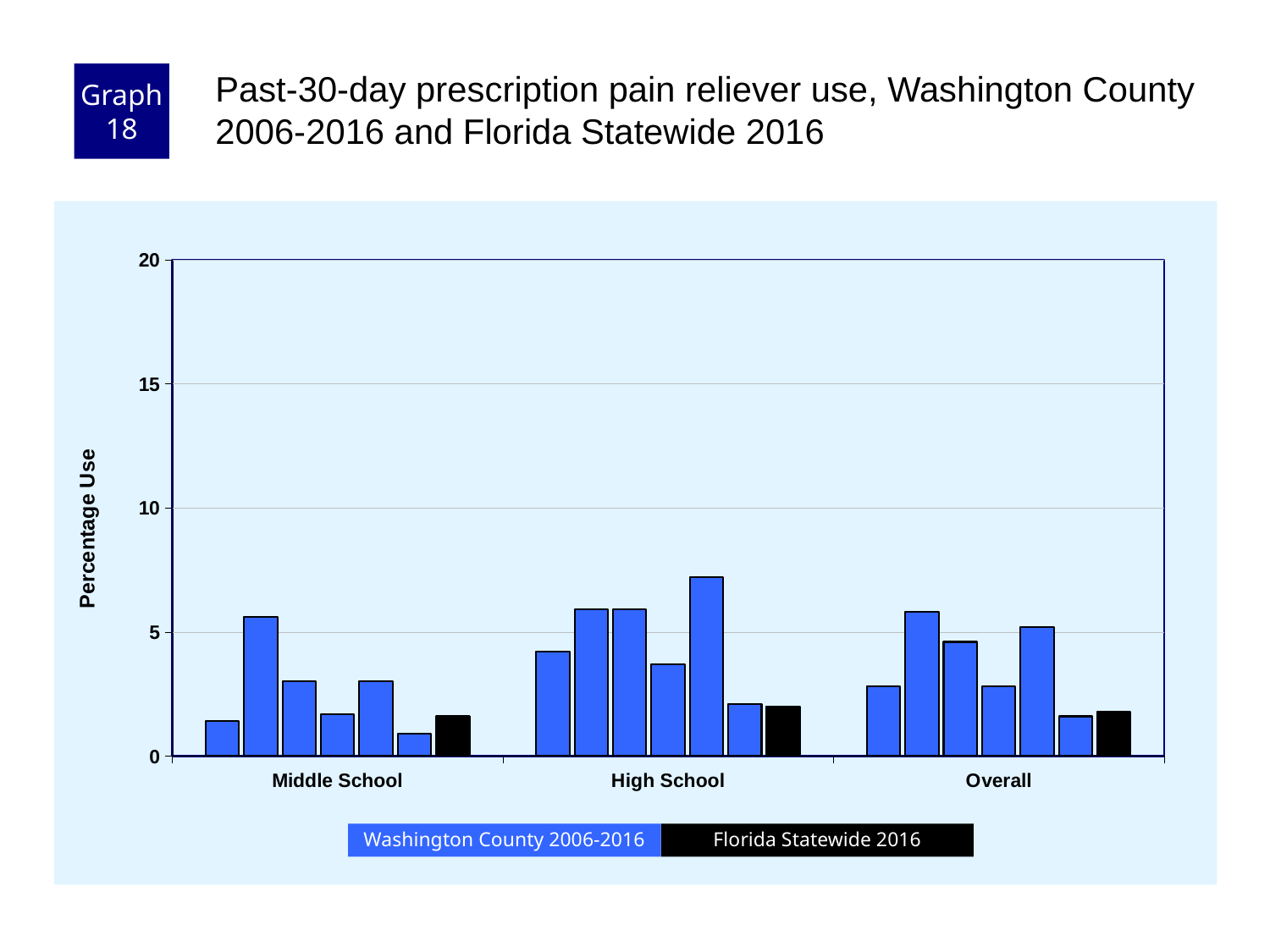
How many categories are shown on the x axis? 3 Which colour represents Florida Statewide 2016 in the legend? Black How many series does the legend list? 2 What is the label of the y axis? Percentage Use Which group contains the tallest bar on the chart: Middle School, High School, or Overall? High School What kind of chart is shown on the slide? Bar chart Is the Florida Statewide 2016 value for Middle School greater or less than 5? less Is the tallest Washington County 2006-2016 bar in the Overall group greater or less than 5? greater Which is larger: the tallest Washington County 2006-2016 bar in the High School group or the Florida Statewide 2016 bar in the High School group? The tallest Washington County 2006-2016 bar Is the Florida Statewide 2016 value for High School greater or less than 5? less